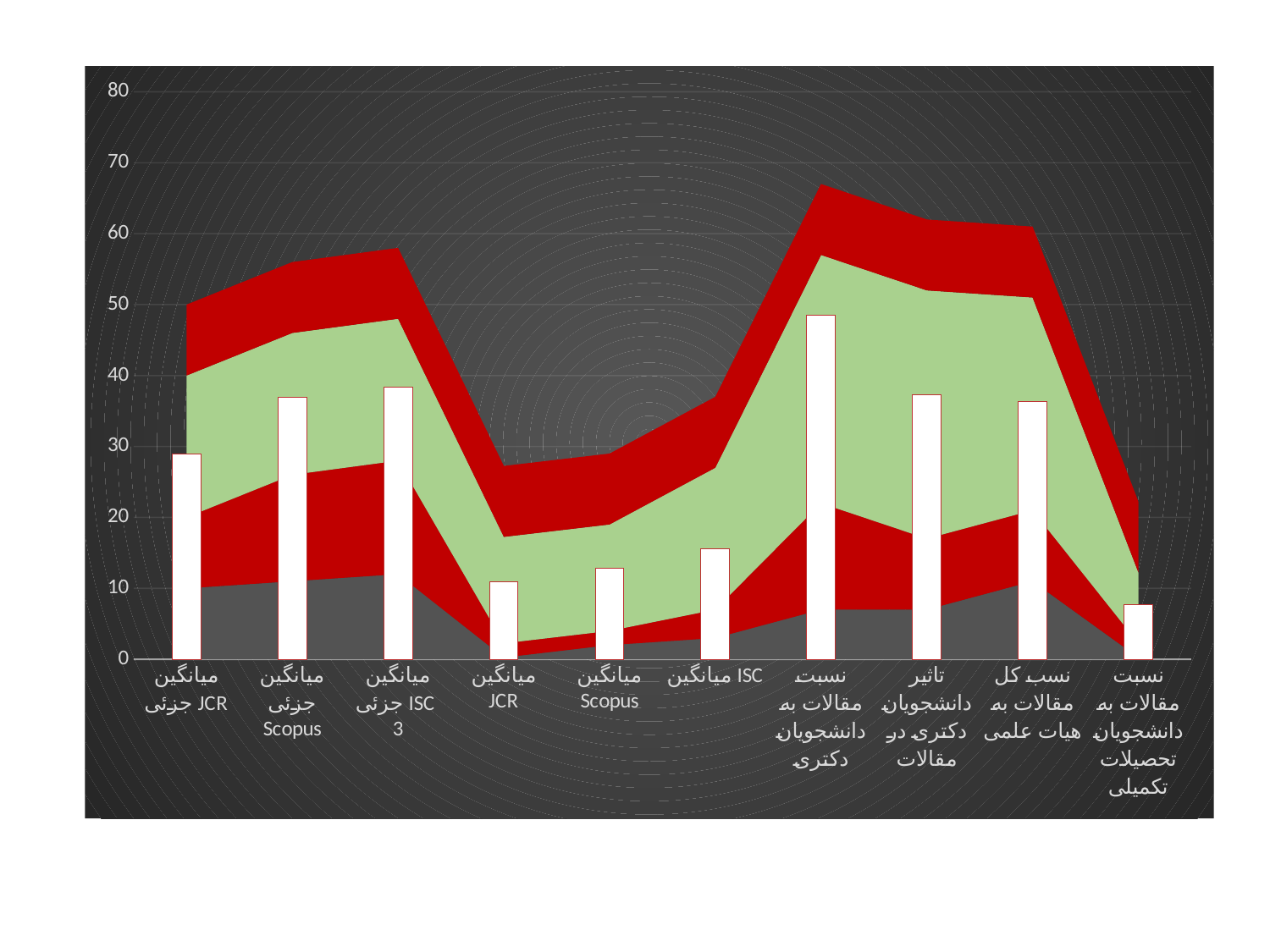
What is the highest value shown on the vertical axis? 80 Which category has the tallest white bar? نسبت مقالات به دانشجویان دکتری Is the white bar for میانگین Scopus greater or less than 20? less Is the white bar for میانگین JCR greater or less than 20? less Is the white bar for نسبت مقالات به دانشجویان دکتری greater or less than 40? greater Which has the taller white bar: میانگین جزئی Scopus or میانگین Scopus? میانگین جزئی Scopus Which category has the shortest white bar? نسبت مقالات به دانشجویان تحصیلات تکمیلی Do the white bars rise or fall from میانگین جزئی ISC 3 to میانگین JCR? fall What kind of chart is this? A combination chart with white bars overlaid on a stacked area chart How many categories are shown along the x axis of the chart? 10